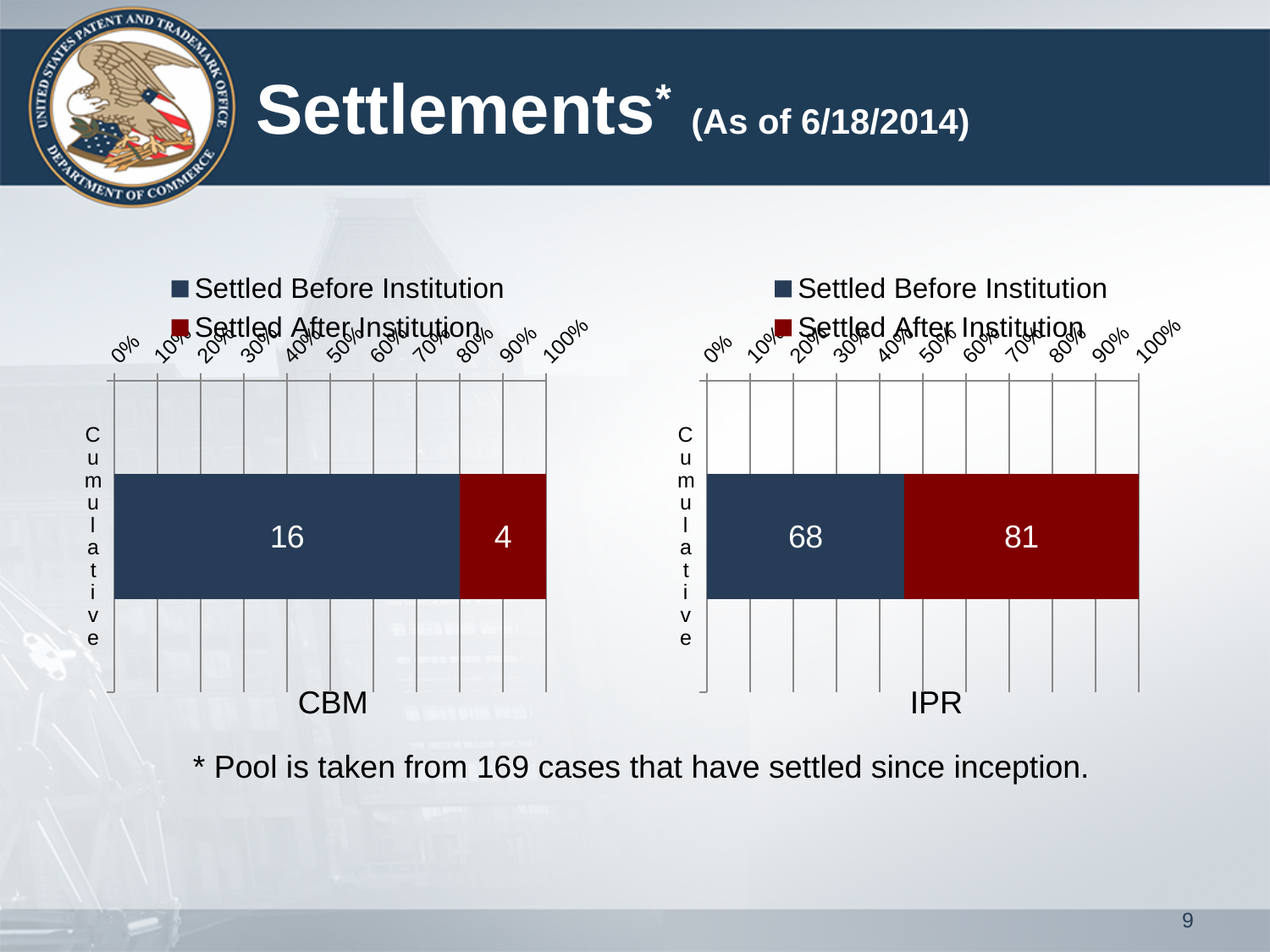
In the CBM chart, what is the value for Settled After Institution? 4 In the CBM chart, is the share of the bar for Settled Before Institution greater or less than 70%? greater In the IPR chart, what is the value for Settled After Institution? 81 In the IPR chart, which is larger, Settled Before Institution or Settled After Institution? Settled After Institution In the CBM chart, what is the total of the stacked bar? 20 In the CBM chart, which is larger, Settled Before Institution or Settled After Institution? Settled Before Institution In the IPR chart, what is the total of the stacked bar? 149 In the CBM chart, what is the value for Settled Before Institution? 16 In the IPR chart, what is the value for Settled Before Institution? 68 What kind of chart is the CBM chart? Stacked bar chart How many series does the legend of the IPR chart list? 2 In the IPR chart, what is the difference between Settled After Institution and Settled Before Institution? 13